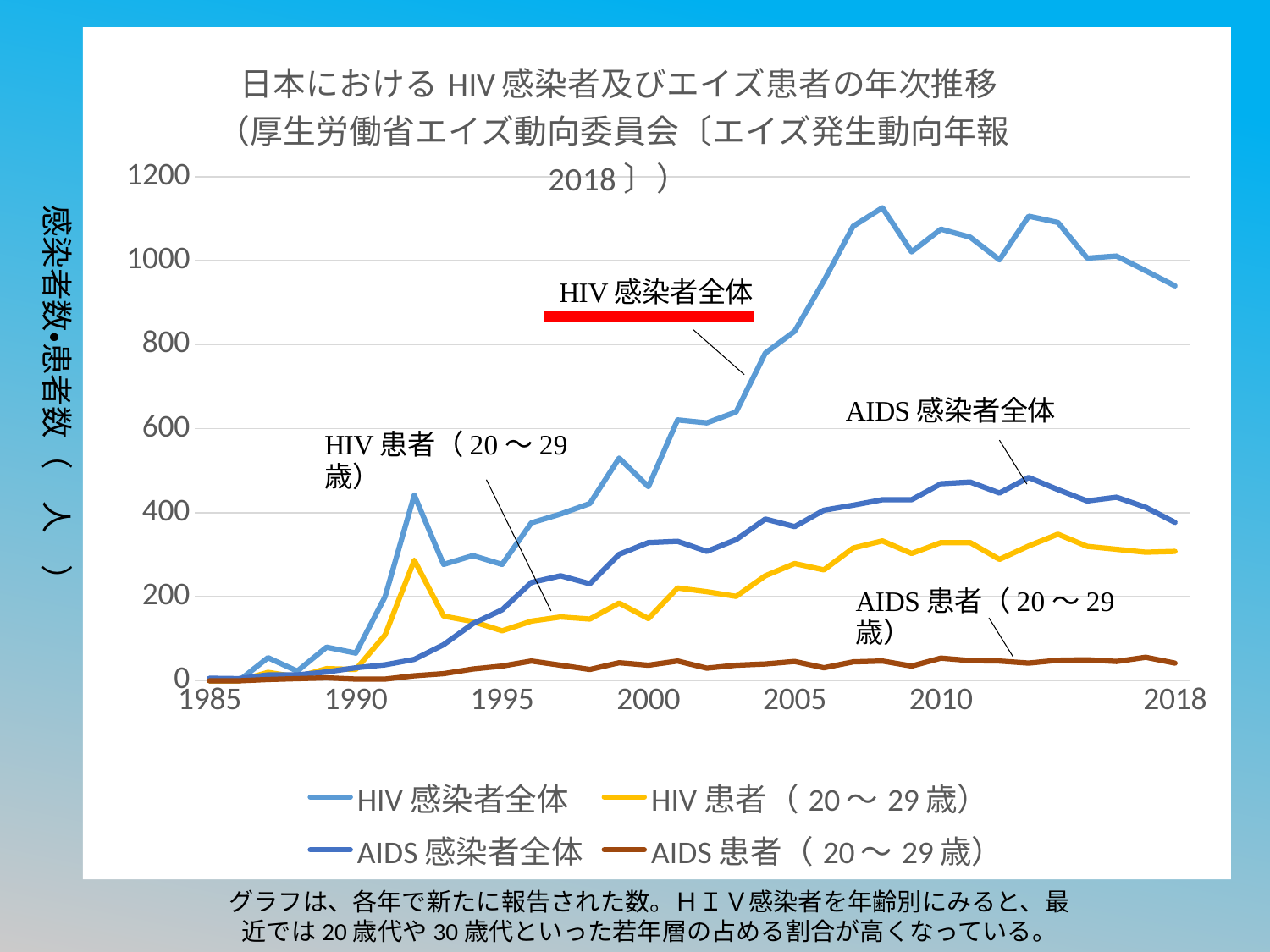
Is the value for AIDS感染者全体 in 2018 greater or less than 600? less What kind of chart is shown on the slide? line chart Is the value for HIV感染者全体 in 2018 greater or less than 1000? less Which series reaches the highest value on the chart? HIV感染者全体 Is the value for AIDS患者（20～29歳） in 2018 greater or less than 200? less Which series stays lowest across the whole chart? AIDS患者（20～29歳） In 2018, which is larger: HIV感染者全体 or AIDS感染者全体? HIV感染者全体 How many series does the legend list? 4 In 2010, which is larger: HIV患者（20～29歳） or AIDS患者（20～29歳）? HIV患者（20～29歳） Does the HIV感染者全体 series generally rise or fall from 1985 to 2008? rise What is the highest tick value shown on the vertical axis? 1200